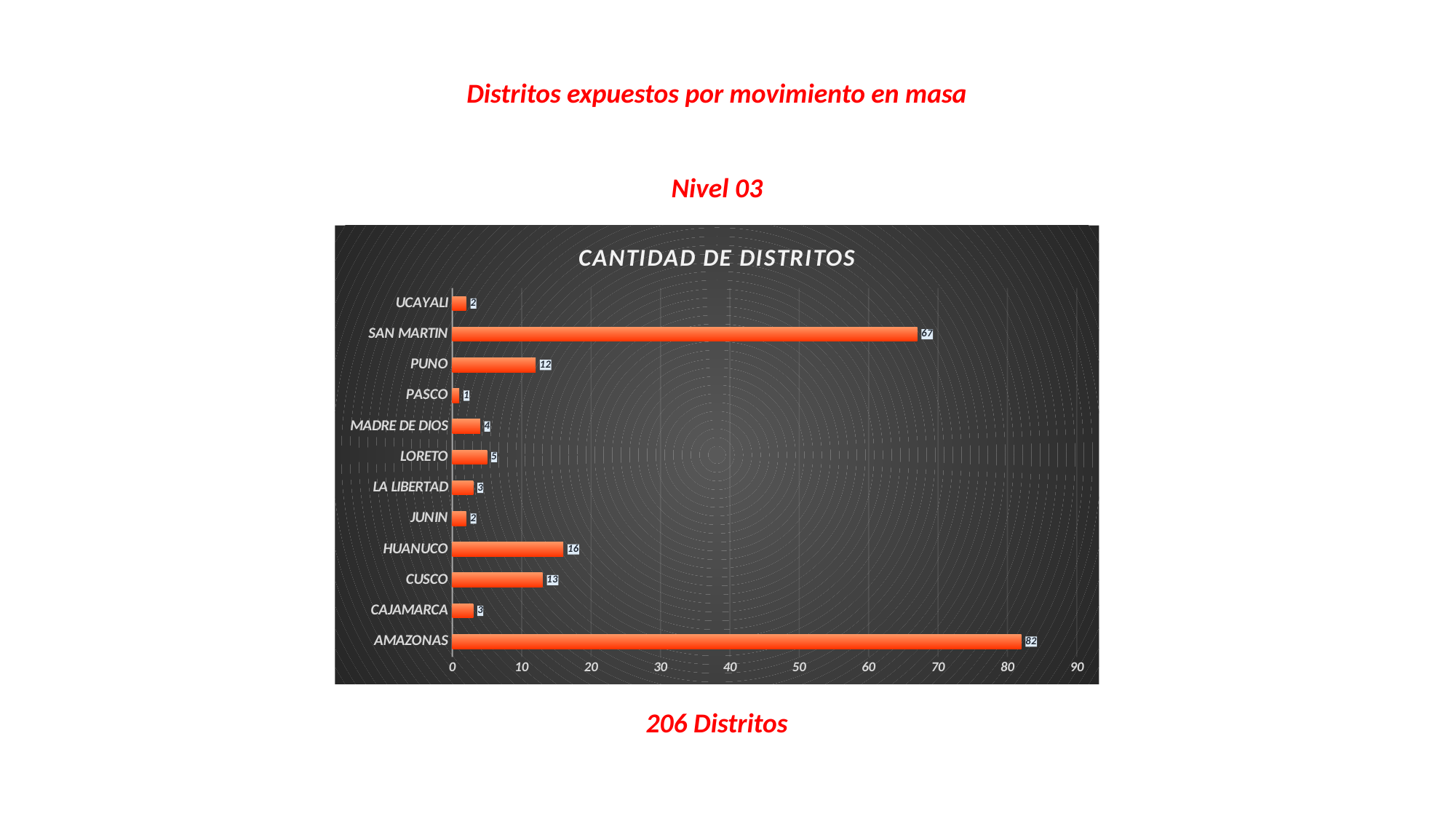
Which is larger, the value for PUNO or the value for CUSCO? CUSCO What is the difference between the values for AMAZONAS and SAN MARTIN? 15 What is the value for SAN MARTIN? 67 What kind of chart is shown on the slide? bar chart Which category has the highest value? AMAZONAS How many categories are shown in the chart? 12 What is the value for HUANUCO? 16 What is the title of the chart? CANTIDAD DE DISTRITOS Which category has the lowest value? PASCO What is the value for PASCO? 1 What is the value for MADRE DE DIOS? 4 Is the value for AMAZONAS greater or less than 80? greater